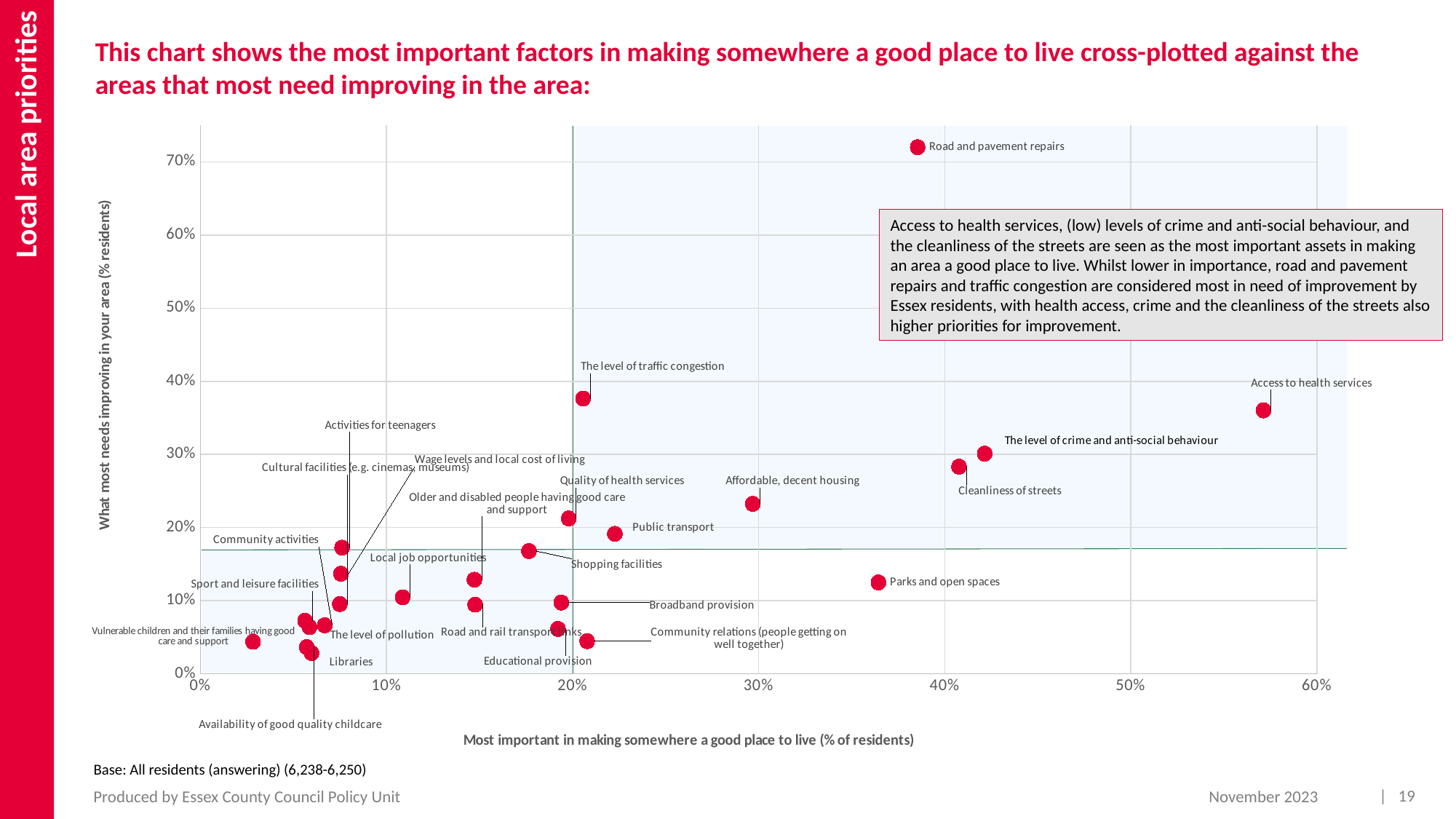
Which has the larger horizontal-axis value, Affordable, decent housing or Public transport? Affordable, decent housing What type of chart is shown on the slide? Scatter chart Is the vertical-axis value for Cleanliness of streets greater or less than 30%? less Is the vertical-axis value for The level of traffic congestion greater or less than 40%? less Which factor has the highest value on the horizontal axis (most important in making somewhere a good place to live)? Access to health services Is the vertical-axis value for Road and pavement repairs greater or less than 70%? greater Which factor has the highest value on the vertical axis (what most needs improving)? Road and pavement repairs Which factor has the lowest value on the horizontal axis? Vulnerable children and their families having good care and support What is the title of the horizontal axis? Most important in making somewhere a good place to live (% of residents) Which has the larger vertical-axis value, Road and pavement repairs or Access to health services? Road and pavement repairs